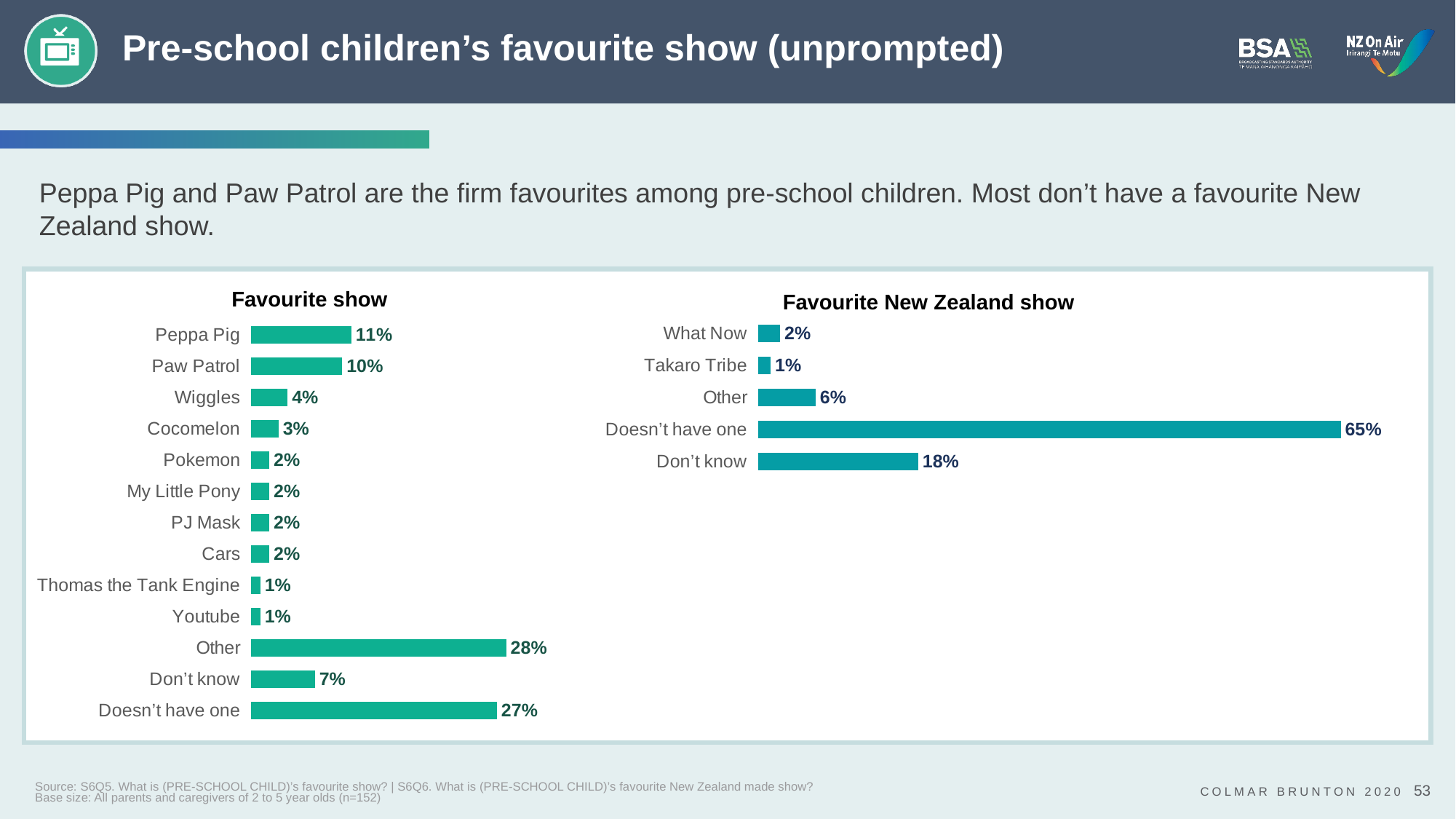
In the 'Favourite show' chart, which category has the highest value? Other In the 'Favourite New Zealand show' chart, which category has the lowest value? Takaro Tribe In the 'Favourite show' chart, which is larger, the value for Other or the value for Doesn't have one? Other How many categories are shown in the 'Favourite New Zealand show' chart? 5 In the 'Favourite New Zealand show' chart, what is the difference between the values for Doesn't have one and Don't know? 47% In the 'Favourite show' chart, what is the value for Wiggles? 4% In the 'Favourite New Zealand show' chart, what is the value for Don't know? 18% In the 'Favourite show' chart, what is the value for Peppa Pig? 11% In the 'Favourite New Zealand show' chart, which category has the highest value? Doesn't have one How many categories are shown in the 'Favourite show' chart? 13 In the 'Favourite show' chart, what is the difference between the values for Peppa Pig and Paw Patrol? 1% What type of chart is the 'Favourite New Zealand show' chart? Bar chart